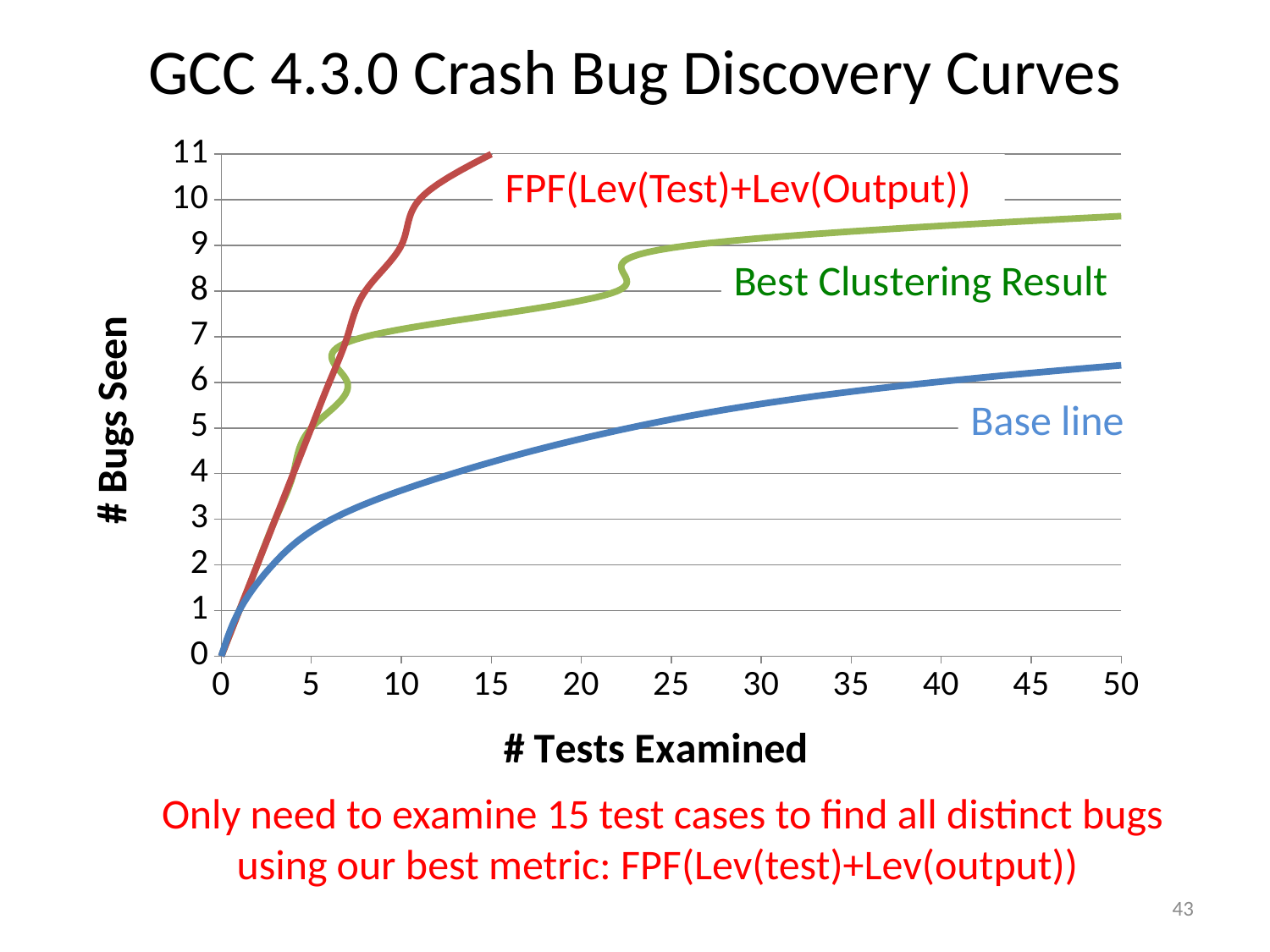
What kind of chart is shown on the slide? line chart What is the label of the y axis? # Bugs Seen Which series has the lowest number of bugs seen at 50 tests examined? Base line Is the Base line value at 50 tests examined greater or less than 7? less Is the Best Clustering Result value at 40 tests examined greater or less than 9? greater Do the number of bugs seen rise or fall as the number of tests examined increases? rise How many series (lines) are plotted on the chart? 3 At 40 tests examined, which series shows more bugs seen: Best Clustering Result or Base line? Best Clustering Result At how many tests examined does the FPF(Lev(Test)+Lev(Output)) curve reach 11 bugs seen? 15 Is the Base line value at 20 tests examined greater or less than 5? less What is the title of the chart? GCC 4.3.0 Crash Bug Discovery Curves Which series reaches the highest number of bugs seen? FPF(Lev(Test)+Lev(Output))